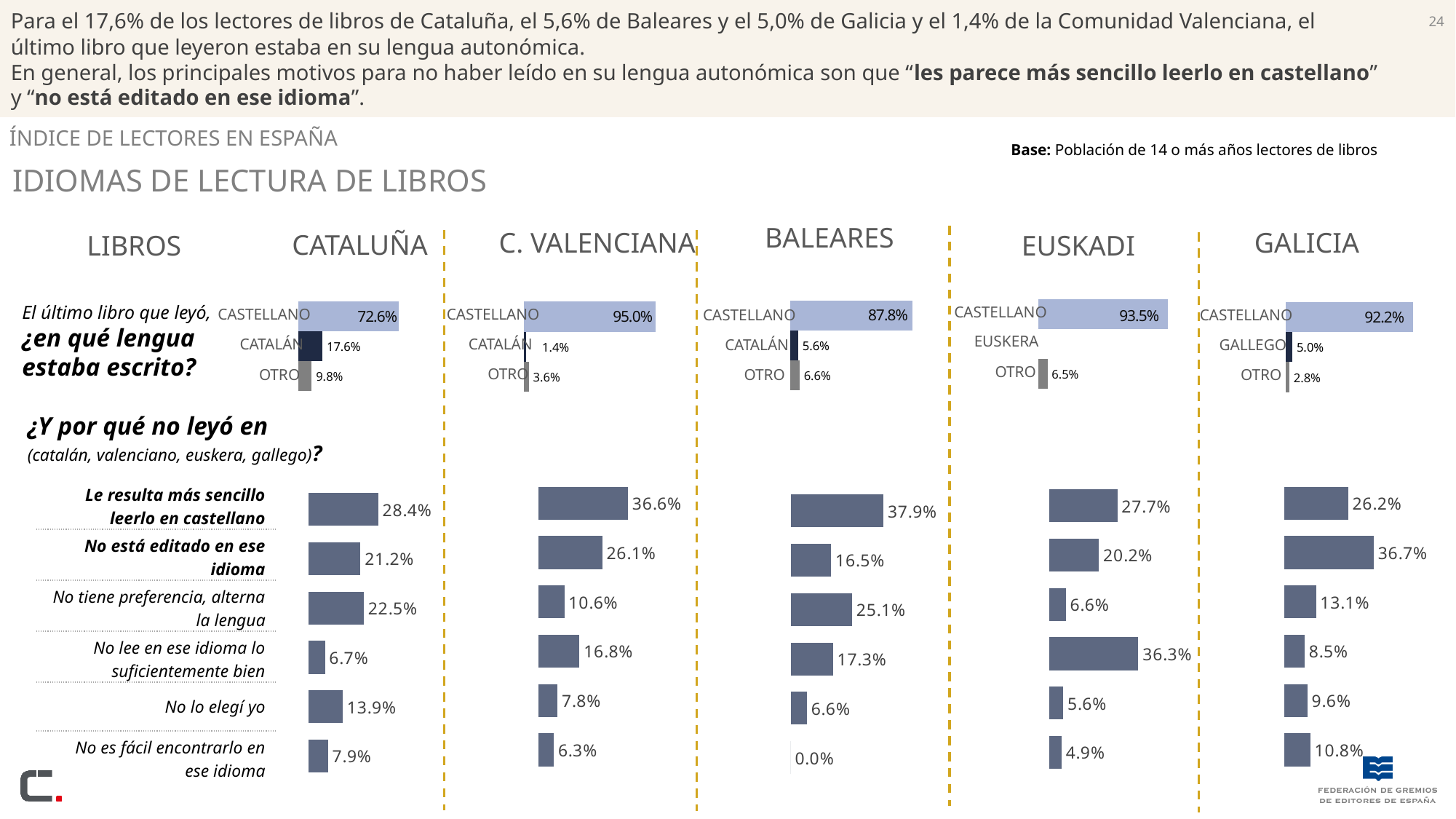
What type of chart is used to show the reasons for not reading in the regional language? Bar chart In the C. Valenciana chart of reasons, which is larger: 'Le resulta más sencillo leerlo en castellano' or 'No está editado en ese idioma'? Le resulta más sencillo leerlo en castellano In the Cataluña chart for the language of the last book read, what percentage is shown for CASTELLANO? 72.6% How many reasons are listed in each chart of reasons for not reading in the regional language? 6 In the Baleares chart of reasons for not reading in the regional language, what is the value for 'No tiene preferencia, alterna la lengua'? 25.1% In the Galicia chart for the language of the last book read, what percentage is shown for GALLEGO? 5.0% In the Cataluña chart for the language of the last book read, what is the difference between the CASTELLANO and CATALÁN percentages? 55.0% In the Euskadi chart for the language of the last book read, what percentage is shown for OTRO? 6.5% In the Euskadi chart of reasons for not reading in the regional language, which reason has the highest value? No lee en ese idioma lo suficientemente bien Among the five regional charts for the language of the last book read, which region has the highest CASTELLANO percentage? C. Valenciana In the Baleares chart of reasons for not reading in the regional language, which reason has the lowest value? No es fácil encontrarlo en ese idioma In the Galicia chart of reasons for not reading in the regional language, which reason has the highest value? No está editado en ese idioma